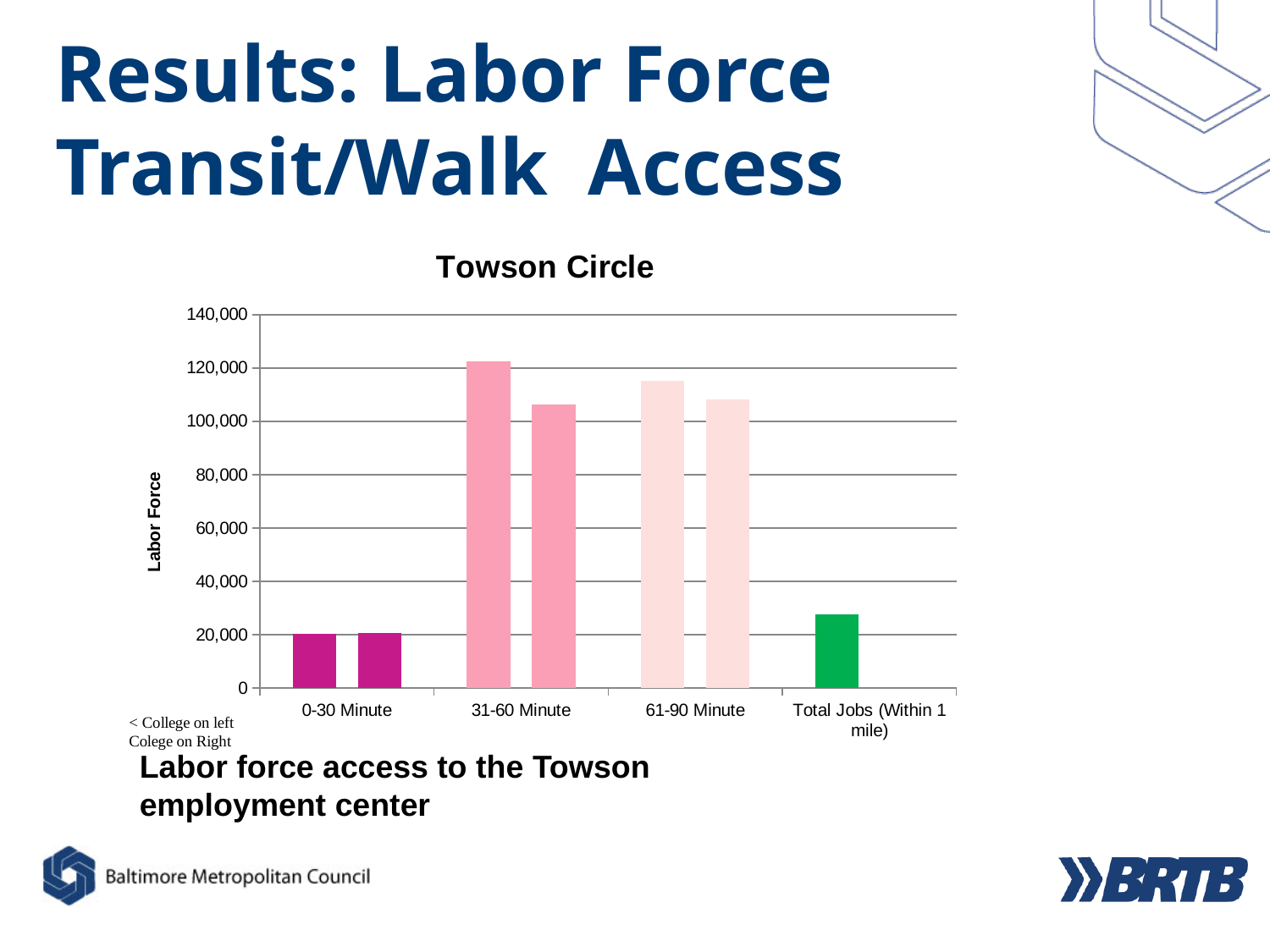
Is the value of the left bar for 0-30 Minute greater or less than 40,000? less What is the title of the chart? Towson Circle How many categories are shown along the x axis of the chart? 4 Is the value of the right bar for 61-90 Minute greater or less than 100,000? greater Which category has the shortest bars in the chart? 0-30 Minute What is the label on the vertical axis of the chart? Labor Force Is the value for Total Jobs (Within 1 mile) greater or less than 20,000? greater Which is larger: the left bar for 0-30 Minute or the bar for Total Jobs (Within 1 mile)? Total Jobs (Within 1 mile) Which category has the tallest bar in the chart? 31-60 Minute What kind of chart is shown on the slide? bar chart Which is larger: the left bar for 31-60 Minute or the left bar for 61-90 Minute? 31-60 Minute